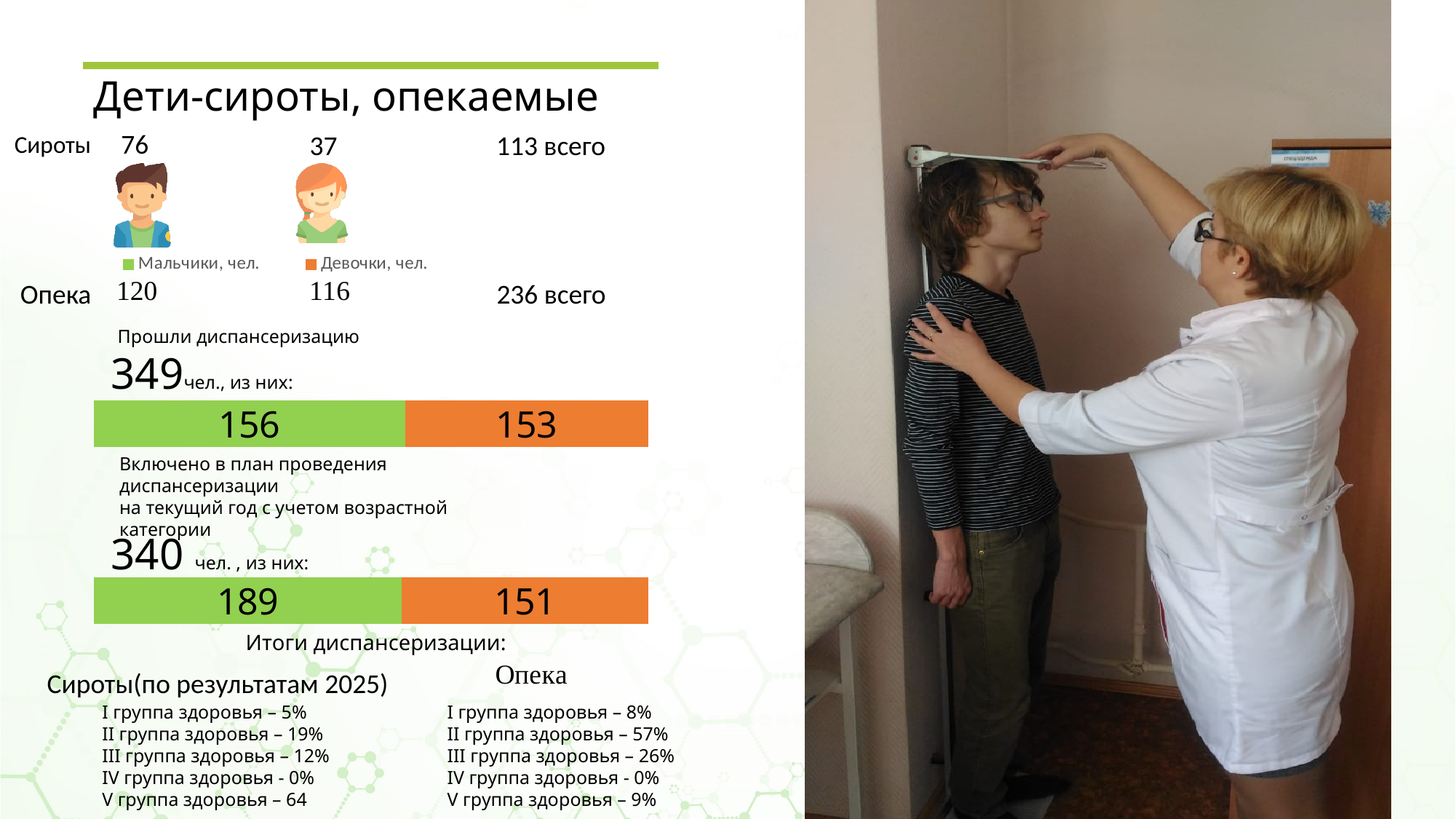
In the lower stacked bar (under "340 чел., из них"), what is the difference between the Мальчики and Девочки values? 38 What kind of chart is used to show the Мальчики and Девочки breakdown on the slide? Bar chart In the upper stacked bar (under "Прошли диспансеризацию 349 чел., из них"), which series has the larger value, Мальчики or Девочки? Мальчики In the upper stacked bar (under "Прошли диспансеризацию 349 чел., из них"), what is the value for Мальчики, чел.? 156 In the lower stacked bar (under "340 чел., из них"), what is the value for Девочки, чел.? 151 What colour represents Девочки, чел. in the stacked bars? Orange In the lower stacked bar (under "340 чел., из них"), what is the value for Мальчики, чел.? 189 How many series does the legend (Мальчики, чел. / Девочки, чел.) list? 2 In the upper stacked bar (under "Прошли диспансеризацию 349 чел., из них"), what is the difference between the Мальчики and Девочки values? 3 What is the total of the lower stacked bar (under "340 чел., из них") based on its two data labels? 340 In the lower stacked bar (under "340 чел., из них"), which series has the larger value, Мальчики or Девочки? Мальчики In the upper stacked bar (under "Прошли диспансеризацию 349 чел., из них"), what is the value for Девочки, чел.? 153